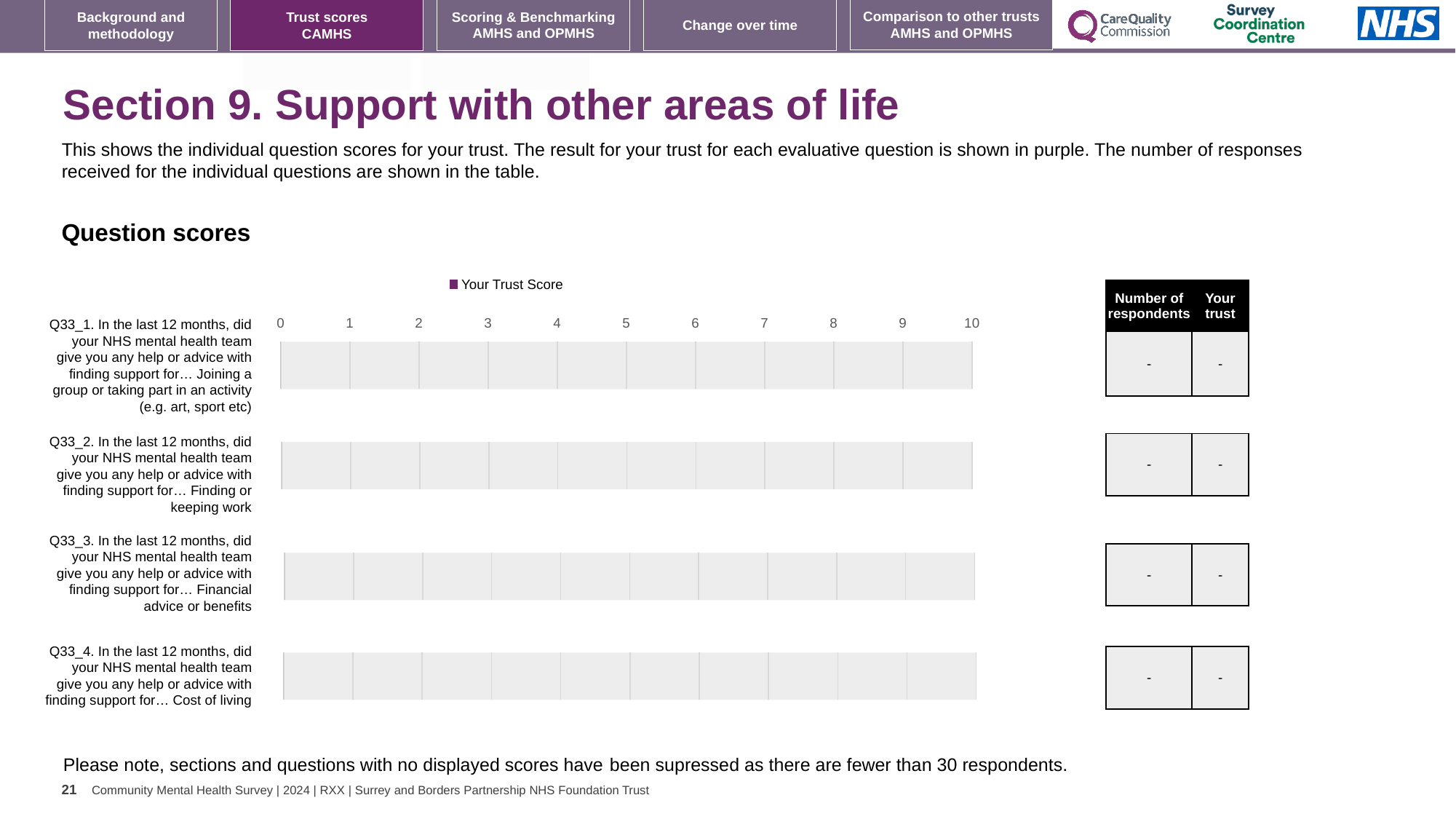
What value is shown in the 'Number of respondents' column of the table for Q33_1 (Joining a group or taking part in an activity)? - How many question categories are listed on the chart's vertical axis? 4 How many series does the chart legend list? 1 What is the name of the series shown in the chart legend? Your Trust Score What value is shown in the 'Your trust' column of the table for Q33_4 (Cost of living)? - What is the highest value shown on the chart's horizontal axis? 10 What kind of chart is shown under 'Question scores'? Bar chart